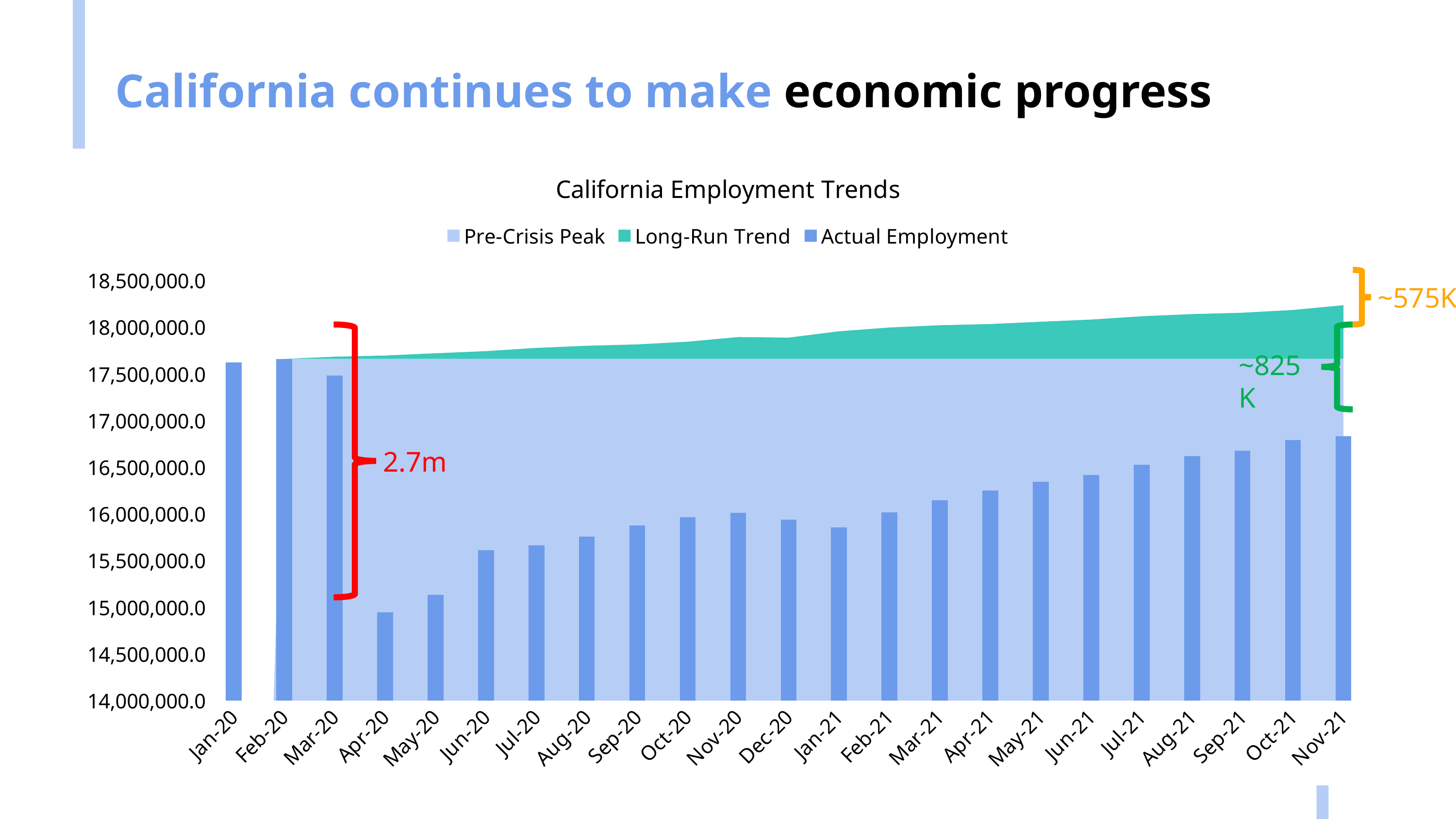
How many series does the legend list? 3 Which has the higher Actual Employment bar, Apr-20 or May-20? May-20 What is the title of the chart? California Employment Trends Is the Actual Employment value for May-20 greater or less than 15,000,000.0? greater Which has the higher Actual Employment bar, Mar-21 or Apr-21? Apr-21 How many months are shown on the x axis? 23 Is the Actual Employment value for Nov-21 greater or less than 16,500,000.0? greater Is the Actual Employment value for Jan-21 greater or less than 16,000,000.0? less Which month has the lowest Actual Employment bar? Apr-20 Do the Actual Employment bars rise or fall from Jan-21 to Nov-21? rise What value does the red bracket annotation next to Mar-20 show? 2.7m